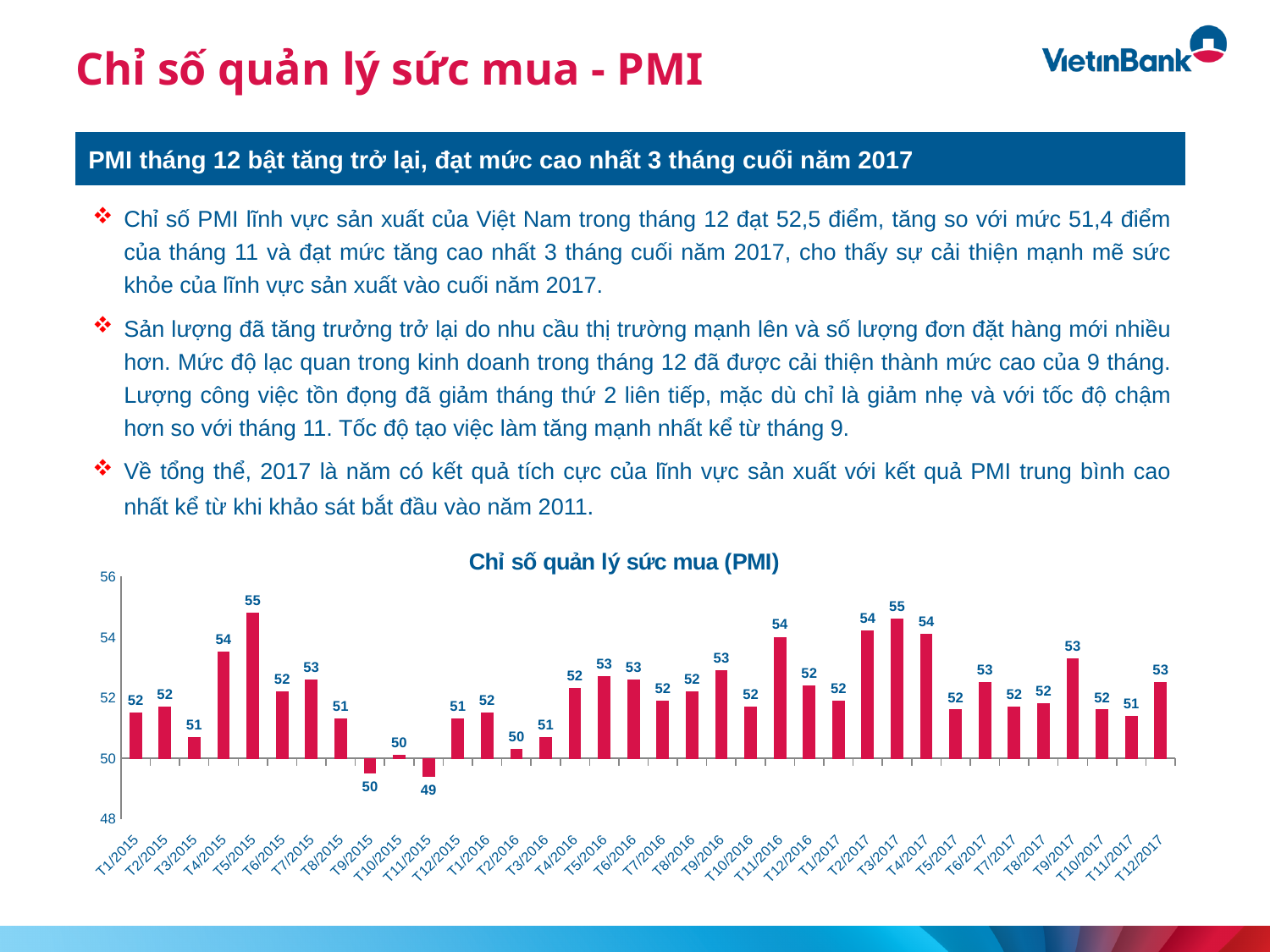
How many monthly bars are plotted in the chart? 36 What is the PMI value labeled for T11/2017? 51 Do the PMI values rise or fall from T3/2017 to T5/2017? fall Is the value for T5/2015 greater or less than 54? greater What is the PMI value labeled for T3/2017? 55 What is the PMI value labeled for T12/2017? 53 Which is larger, the PMI for T4/2015 or for T3/2015? T4/2015 Which month has the lowest PMI value in the chart? T11/2015 Is the value for T11/2015 greater or less than 50? less What kind of chart is shown on the slide? bar chart What is the title of the chart? Chỉ số quản lý sức mua (PMI) What is the difference between the labeled values for T5/2015 and T11/2015? 6